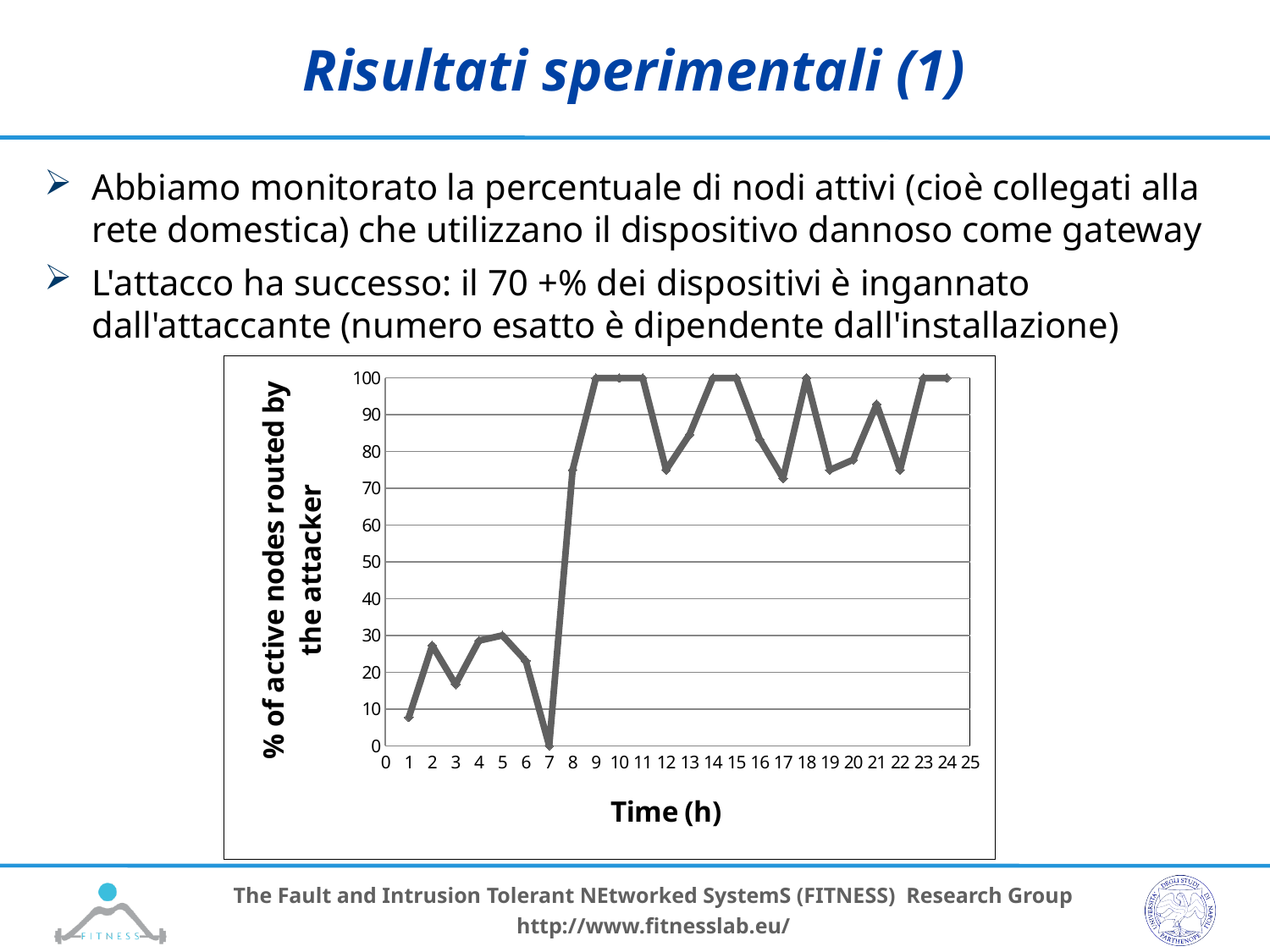
Which is larger, the value at hour 5 or the value at hour 8? hour 8 Is the value at hour 1 greater or less than 10? less Is the value at hour 5 greater or less than 20? greater Is the value at hour 12 greater or less than 80? less Does the line generally rise or fall between hour 7 and hour 9? rise What is the label of the y axis of the chart? % of active nodes routed by the attacker What is the value of the line at hour 10? 100 At which hour does the line reach its lowest value? 7 What is the value of the line at hour 7? 0 What is the label of the x axis of the chart? Time (h) What kind of chart is shown on the slide? line chart